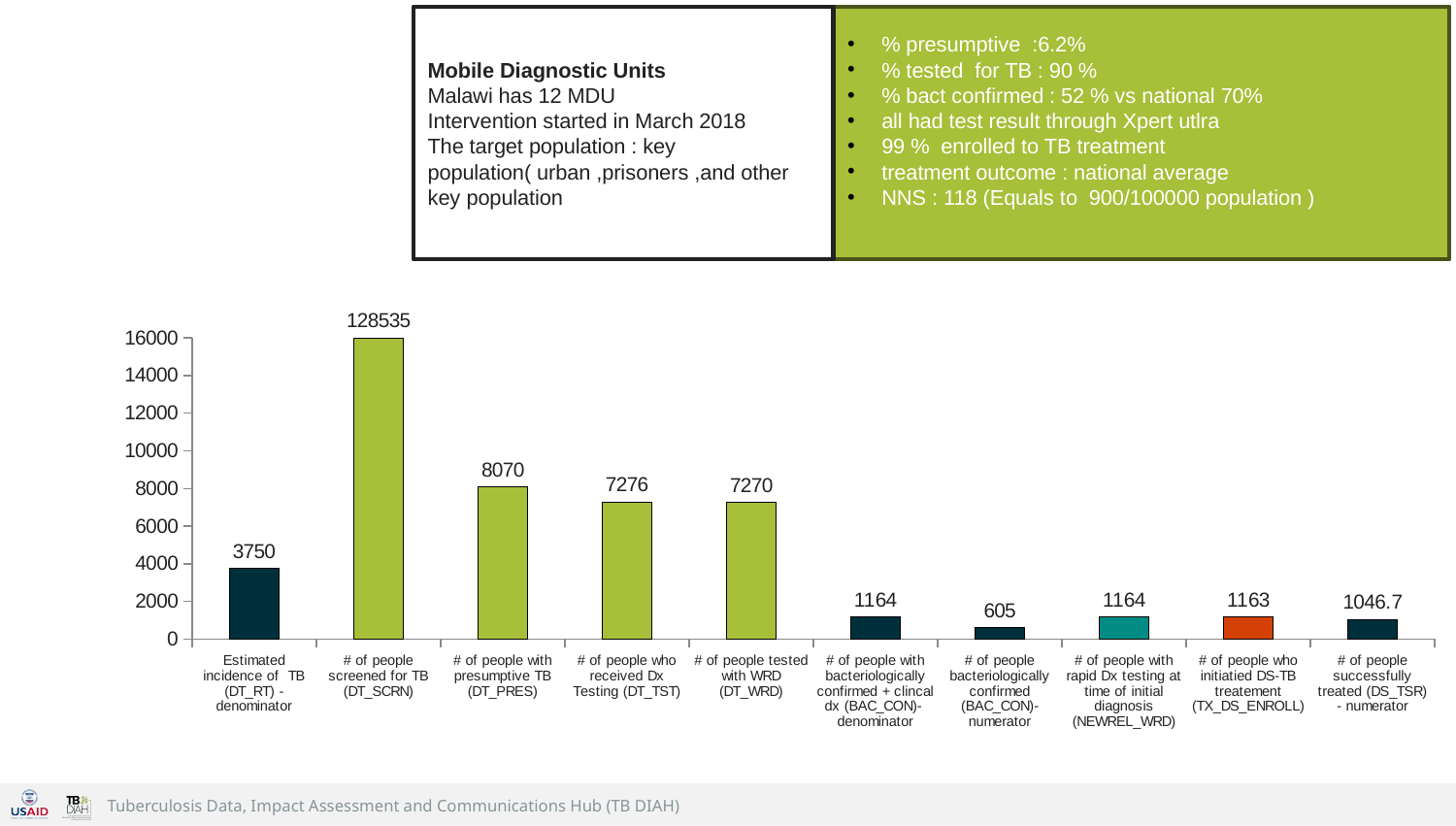
Which category has the highest value? # of people screened for TB (DT_SCRN) What kind of chart is shown on the slide? bar chart What is the value for # of people with presumptive TB (DT_PRES)? 8070 What is the value for # of people who initiatied DS-TB treatement (TX_DS_ENROLL)? 1163 What is the value for # of people screened for TB (DT_SCRN)? 128535 What is the difference between # of people with presumptive TB (DT_PRES) and # of people who received Dx Testing (DT_TST)? 794 What is the difference between # of people who received Dx Testing (DT_TST) and # of people tested with WRD (DT_WRD)? 6 Which category has the lowest value? # of people bacteriologically confirmed (BAC_CON) - numerator How many categories are shown on the x axis? 10 What is the value for # of people bacteriologically confirmed (BAC_CON) - numerator? 605 What is the value for # of people successfully treated (DS_TSR) - numerator? 1046.7 Which is larger: Estimated incidence of TB (DT_RT) - denominator or # of people with presumptive TB (DT_PRES)? # of people with presumptive TB (DT_PRES)